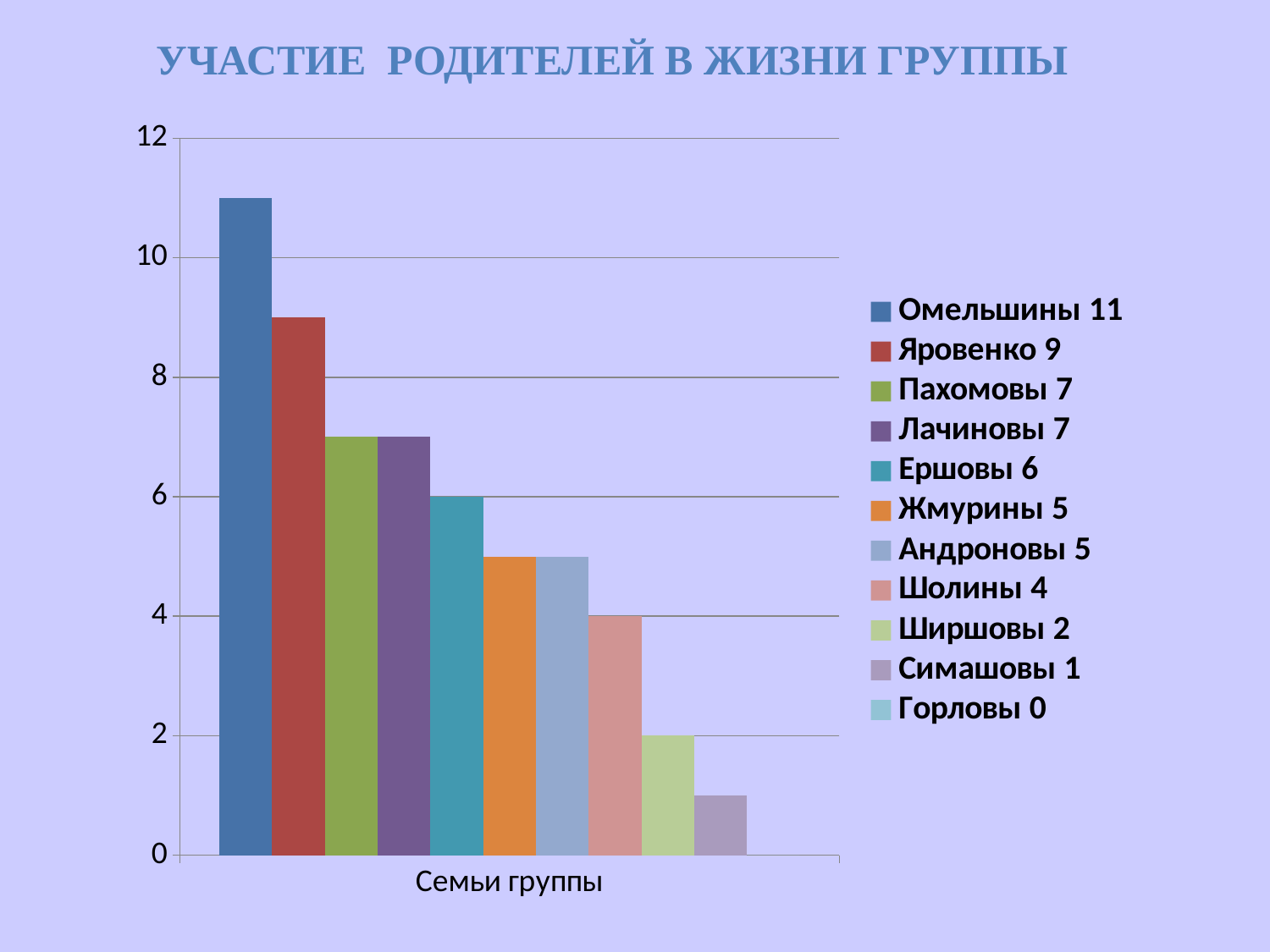
Which family has the lowest value? Горловы Do the bar values rise or fall from left to right along the x axis? fall What type of chart is shown on the slide? bar chart What is the title of the chart? УЧАСТИЕ РОДИТЕЛЕЙ В ЖИЗНИ ГРУППЫ Which is larger, the value for Ширшовы or the value for Симашовы? Ширшовы Is the value for Яровенко greater or less than 8? greater What is the value for Омельшины? 11 Which family has the highest value? Омельшины What is the difference between the values for Омельшины and Яровенко? 2 What is the value for Шолины? 4 How many series does the legend list? 11 What is the value for Ершовы? 6